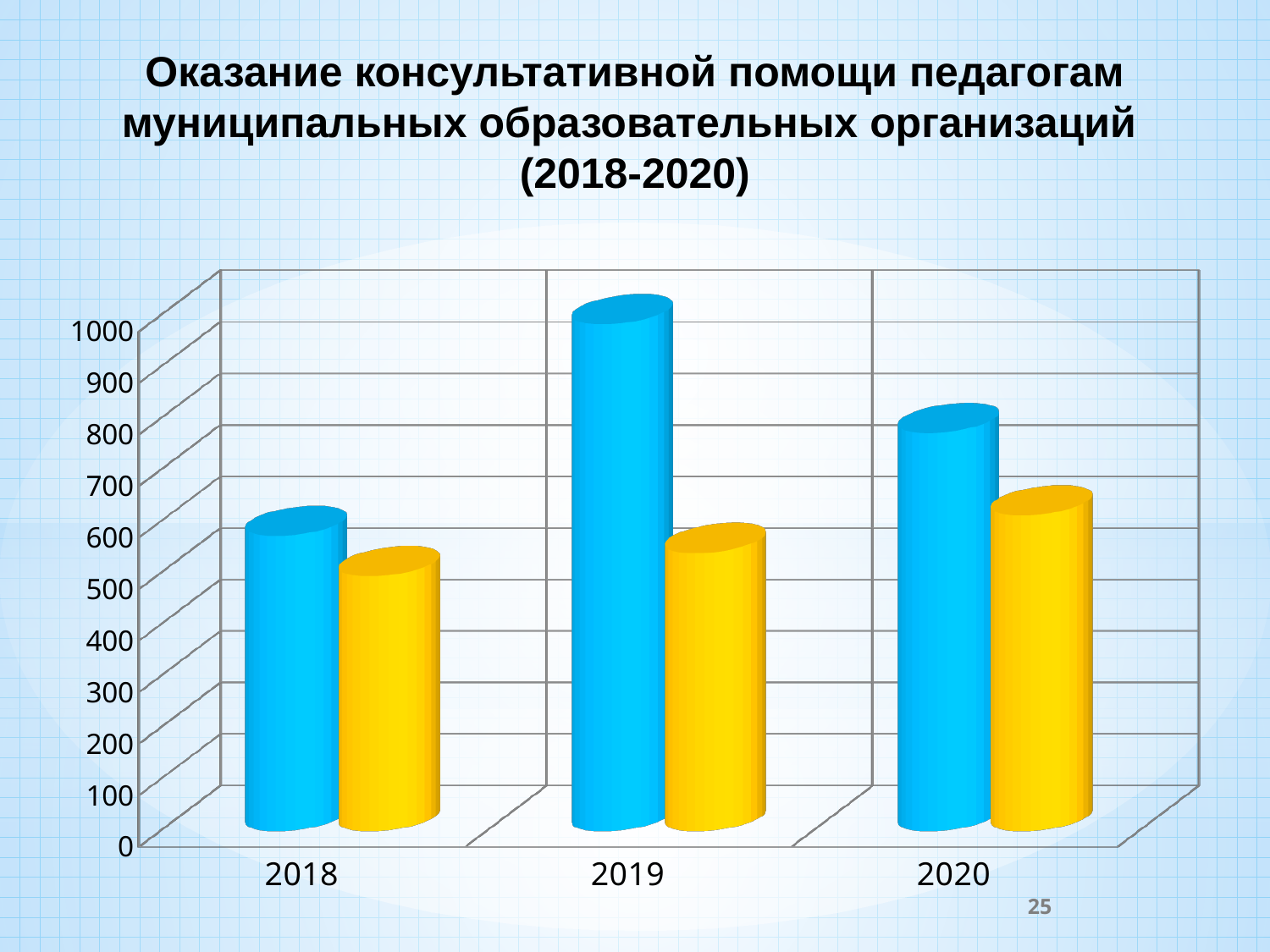
Is the value of the blue bar for 2020 greater or less than 700? greater In which year is the blue bar the lowest? 2018 In 2019, which bar is taller, the blue one or the yellow one? the blue one What kind of chart is shown on the slide? bar chart In which year is the blue bar the highest? 2019 What period is given in parentheses in the chart title? 2018-2020 In which year is the yellow bar the highest? 2020 How many years are shown on the x axis of the chart? 3 Do the yellow bars rise or fall from 2018 to 2020? rise Is the value of the blue bar for 2019 greater or less than 900? greater Is the value of the yellow bar for 2018 greater or less than 600? less How many bars are shown for each year in the chart? 2